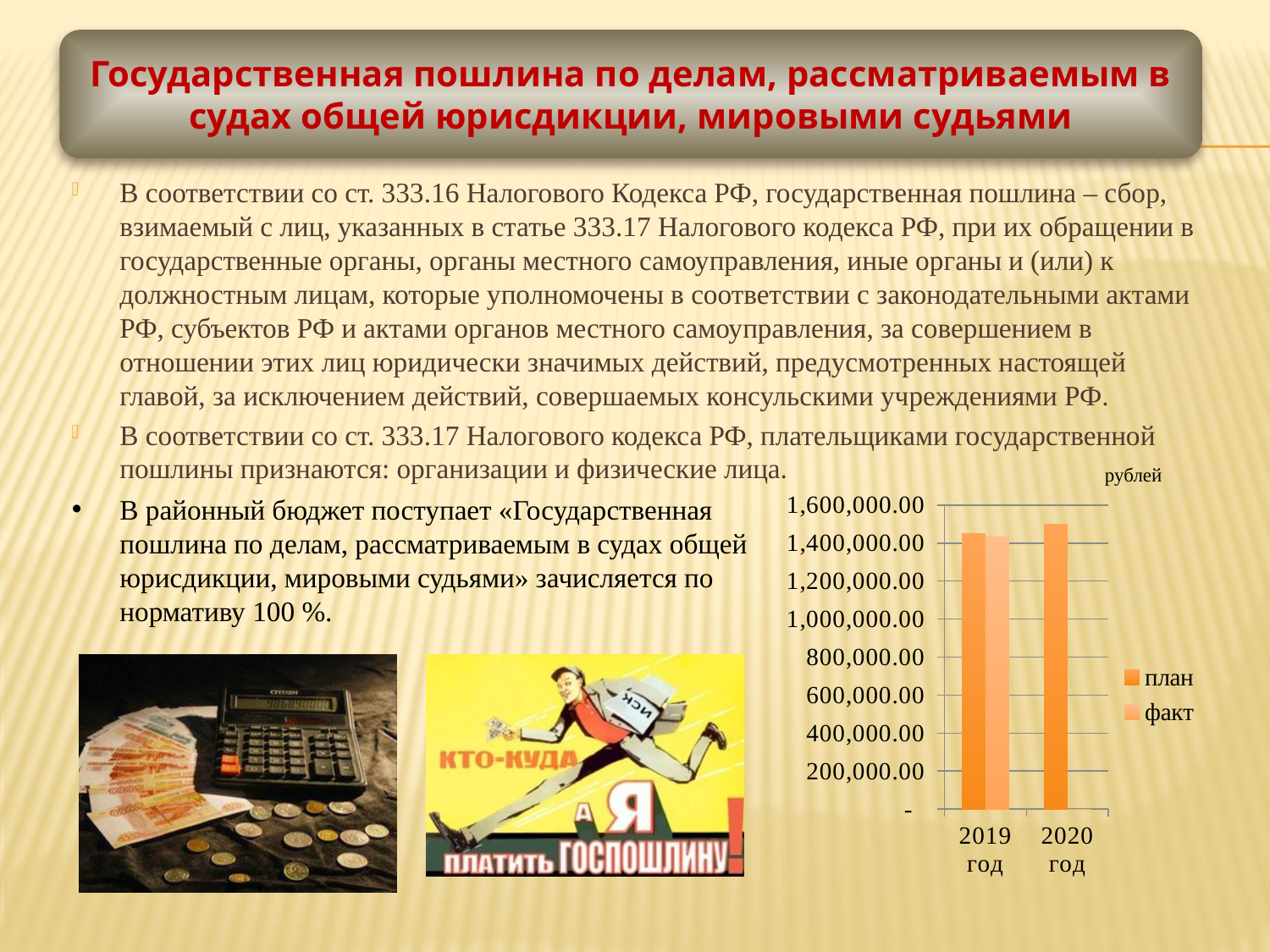
Which year has the lowest факт value? 2020 год Is the value for факт in 2020 год greater or less than 200,000.00? less Is the value for план in 2019 год greater or less than 1,400,000.00? greater What kind of chart is shown on the slide? bar chart Does the факт series rise or fall from 2019 год to 2020 год? fall Is the value for план in 2020 год greater or less than 1,400,000.00? greater Which is larger in 2020 год, план or факт? план Which year has the higher план value, 2019 год or 2020 год? 2020 год What are the series names listed in the chart legend? план, факт What unit label is shown above the chart? рублей How many series does the chart legend list? 2 How many categories are shown on the x axis of the chart? 2